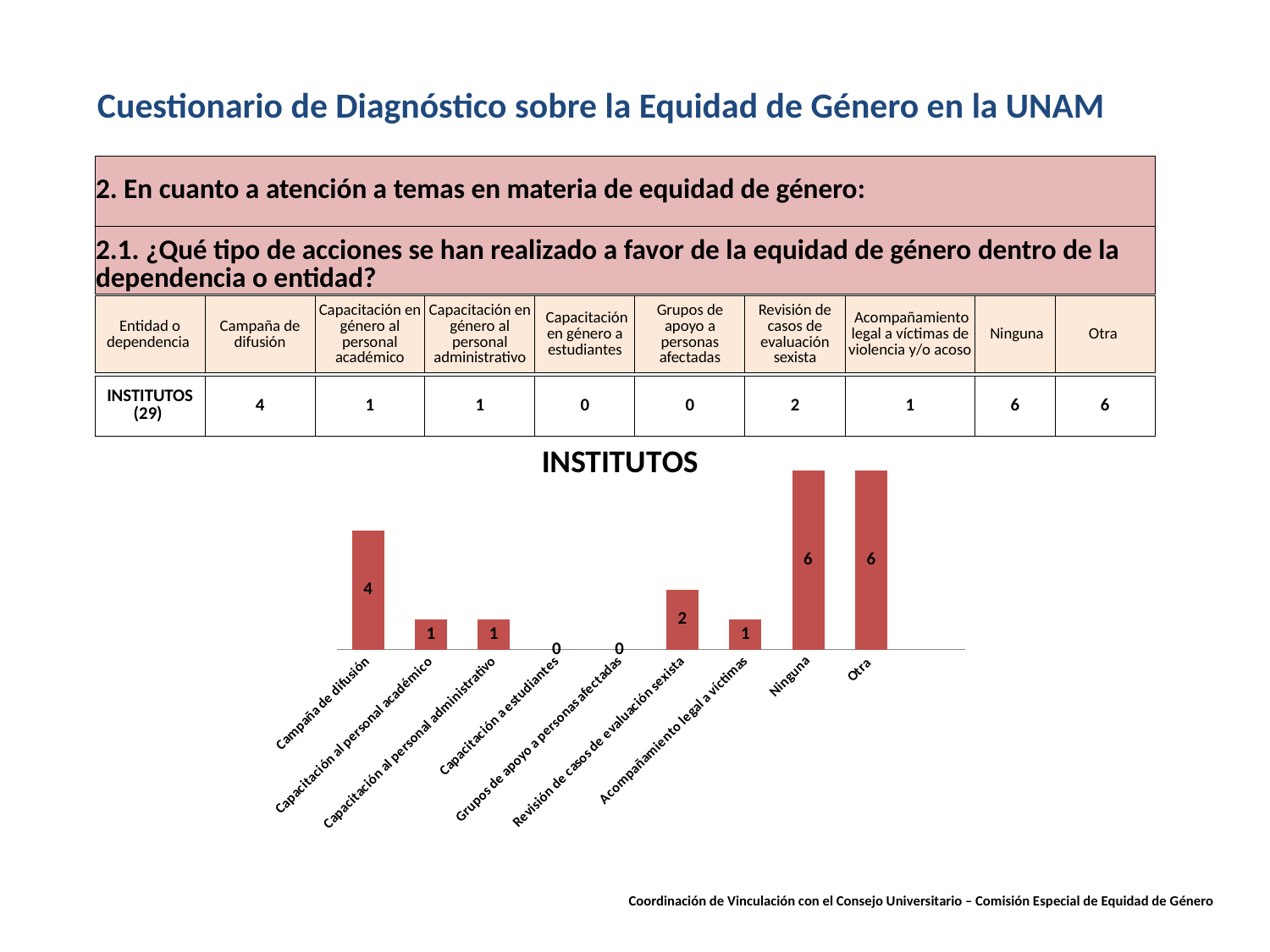
Which categories have the lowest value in the INSTITUTOS chart? Capacitación a estudiantes and Grupos de apoyo a personas afectadas What is the value for Ninguna in the INSTITUTOS chart? 6 What is the difference between the values for Otra and Acompañamiento legal a víctimas in the INSTITUTOS chart? 5 What is the value for Revisión de casos de evaluación sexista in the INSTITUTOS chart? 2 What kind of chart is the INSTITUTOS chart? Bar chart Which is larger in the INSTITUTOS chart, Campaña de difusión or Revisión de casos de evaluación sexista? Campaña de difusión What is the title of the chart on the slide? INSTITUTOS What is the value for Campaña de difusión in the INSTITUTOS chart? 4 What is the value for Capacitación a estudiantes in the INSTITUTOS chart? 0 What colour are the bars in the INSTITUTOS chart? Red What is the difference between the values for Ninguna and Campaña de difusión in the INSTITUTOS chart? 2 How many categories are shown on the x axis of the INSTITUTOS chart? 9